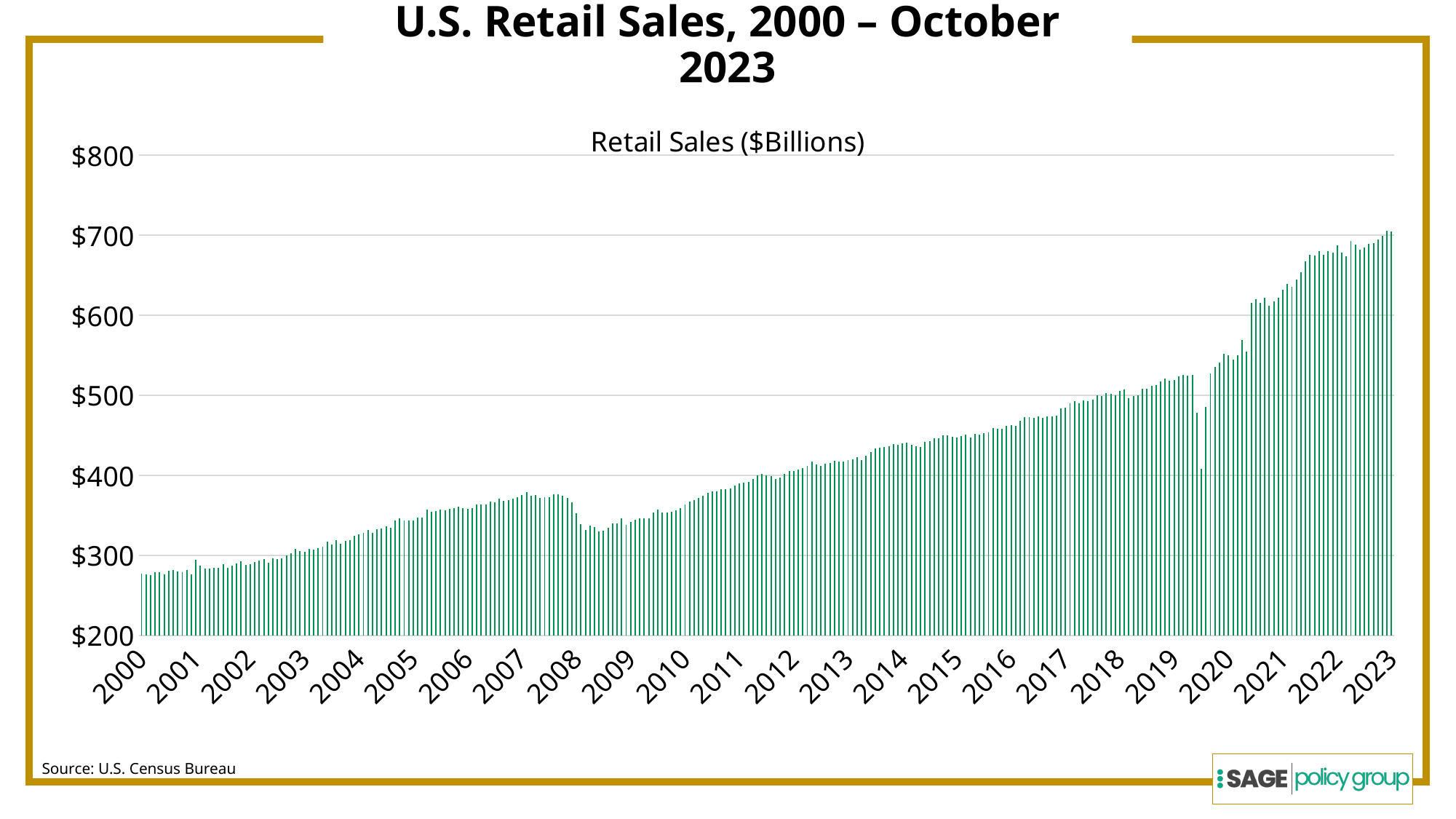
Is the value for retail sales in October 2023 greater or less than $600? greater Which year has the highest retail sales values on the chart? 2023 Is the value for retail sales in 2008 greater or less than $400? less Is the value for retail sales in 2015 greater or less than $400? greater What is the title of the chart? Retail Sales ($Billions) Which year has the lowest retail sales values on the chart? 2000 Which year has higher retail sales, 2007 or 2009? 2007 Do retail sales generally rise or fall from 2000 to 2023? rise What is the source cited for the chart data? U.S. Census Bureau What kind of chart is shown on the slide? bar chart How many year labels are shown on the x axis? 24